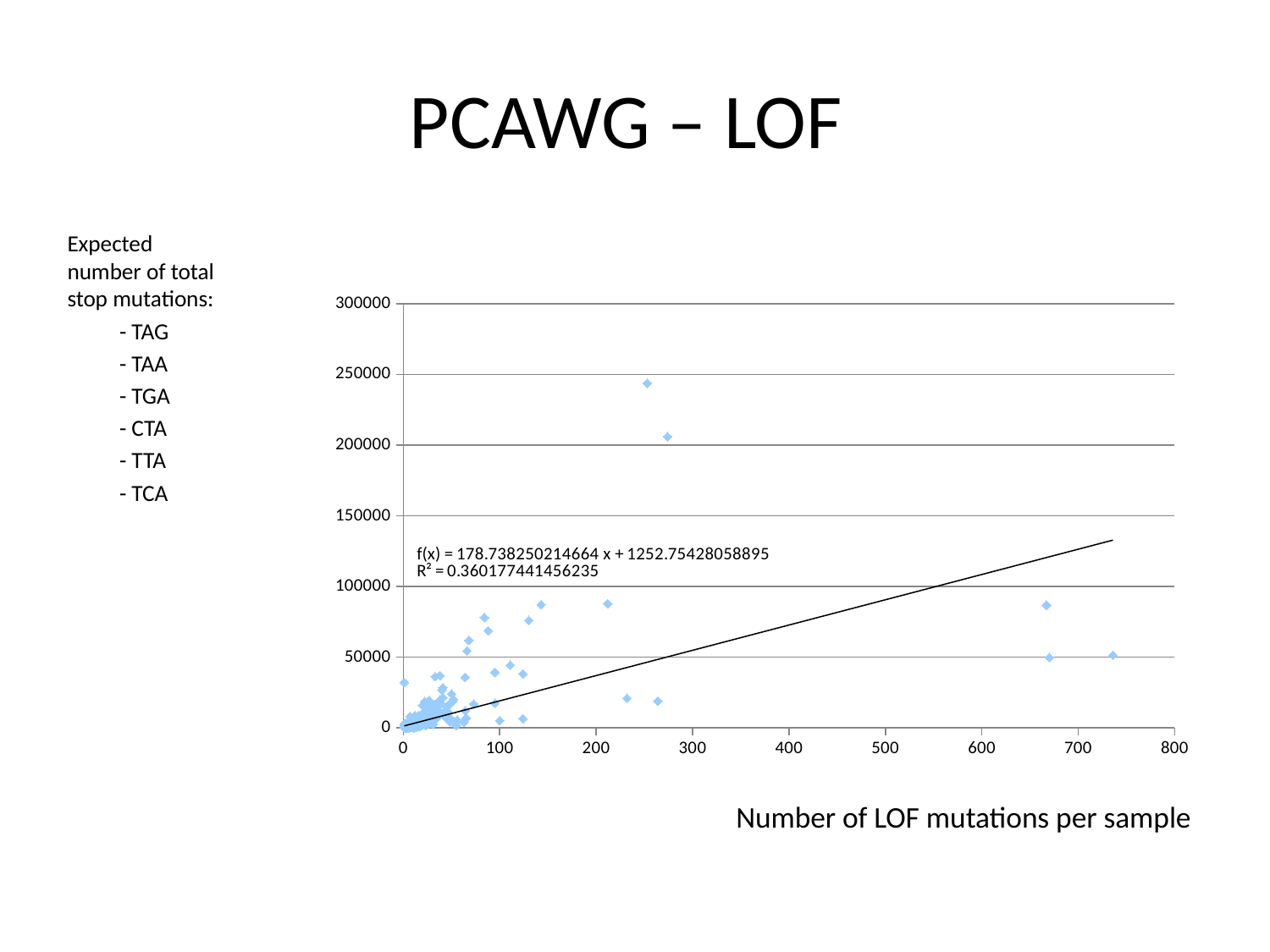
What is the maximum value shown on the x axis of the chart? 800 What is the label of the x axis of the chart? Number of LOF mutations per sample What is the maximum value shown on the y axis of the chart? 300000 What kind of chart is shown on the slide? scatter plot Does the fitted trendline rise or fall as the number of LOF mutations per sample increases? rise What R² value is printed on the chart for the trendline? 0.360177441456235 Is the highest plotted point on the chart greater or less than 200000 on the y axis? greater Is the y value of the rightmost plotted point greater or less than 100000? less What is the slope of the trendline equation printed on the chart? 178.738250214664 Is the highest plotted point on the chart greater or less than 250000 on the y axis? less